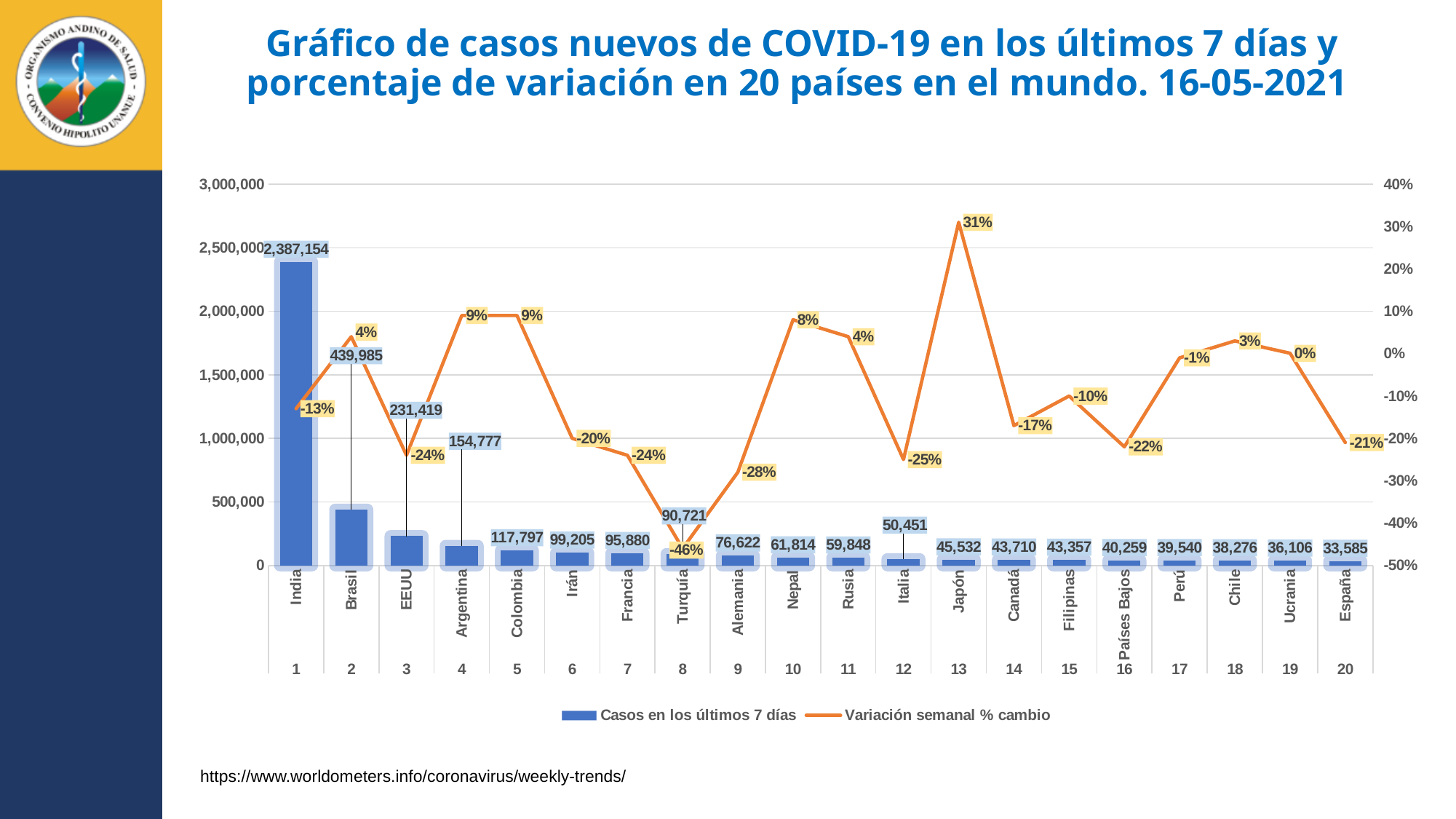
What is the difference in cases in the last 7 days between Brasil and EEUU? 208,566 What is the weekly percentage variation shown for Japón? 31% How many new COVID-19 cases in the last 7 days are shown for India? 2,387,154 What is the weekly percentage variation shown for Turquía? -46% Do the bars for cases in the last 7 days rise or fall from left to right along the x axis? Fall How many countries are shown on the chart? 20 How many series does the legend list? 2 What kind of chart is used to show the cases in the last 7 days? Bar chart Which country has the highest number of cases in the last 7 days? India Which has more cases in the last 7 days, Nepal or Rusia? Nepal Which country has the lowest number of cases in the last 7 days? España Which country has the lowest weekly percentage variation? Turquía